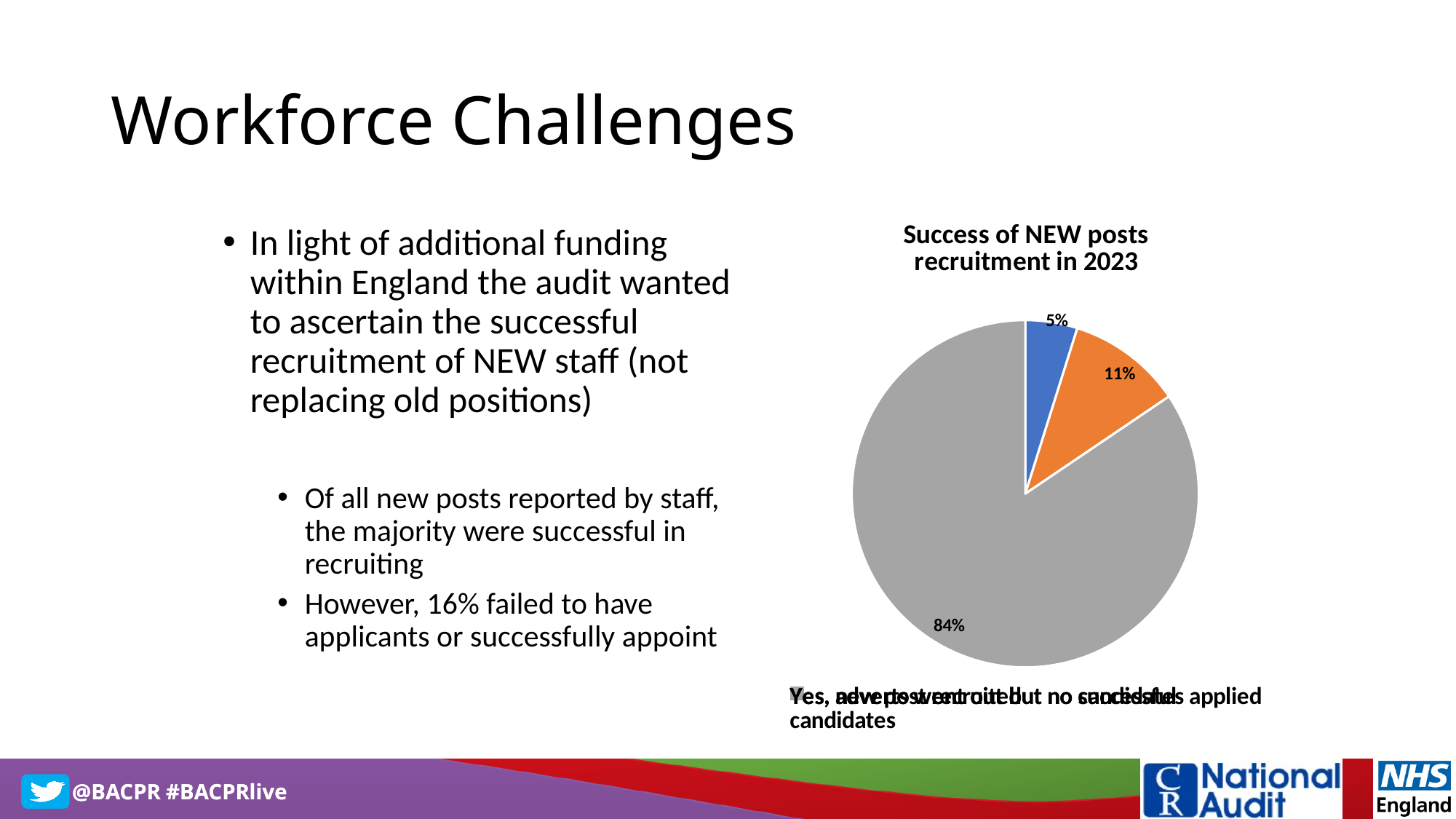
What share of the pie does the grey slice represent? 84% How many slices does the pie chart have? 3 What colour is the largest slice of the pie chart? grey What percentage is shown on the smallest slice of the pie chart? 5% What kind of chart is shown on the slide? pie chart Which slice is larger, the blue slice or the orange slice? orange What is the title of the pie chart? Success of NEW posts recruitment in 2023 What is the combined share of the blue and orange slices? 16% What percentage is shown on the largest slice of the pie chart? 84% What share of the pie does the orange slice represent? 11% What is the difference in percentage points between the grey slice and the orange slice? 73 What share of the pie does the blue slice represent? 5%